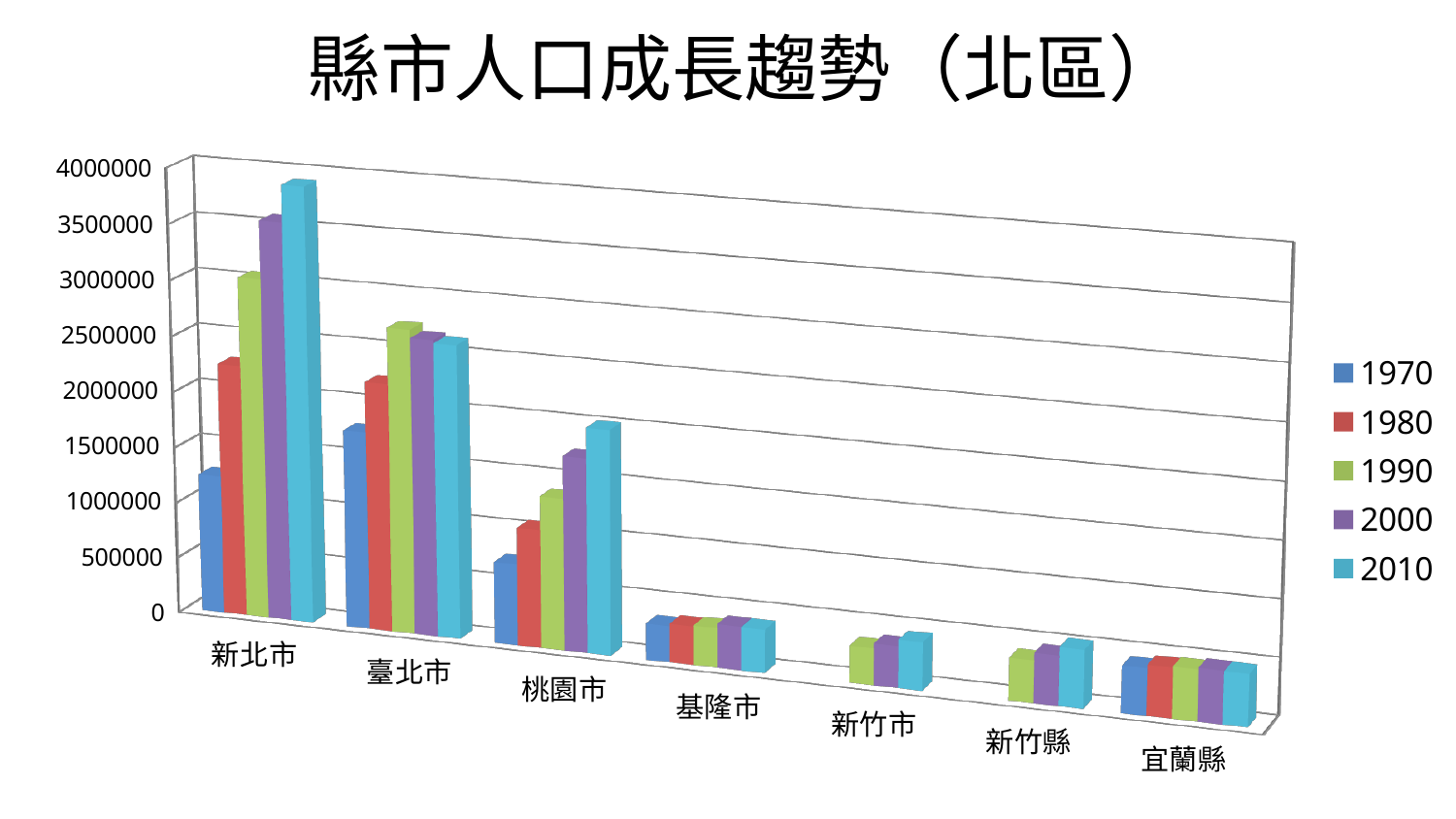
How many series does the legend list? 5 Which is larger for 1970: 新北市 or 臺北市? 臺北市 Which is larger for 桃園市: the 1970 value or the 2010 value? 2010 Which city has the highest value for 2010? 新北市 Do the values for 新北市 rise or fall from 1970 to 2010? rise What is the title of the chart? 縣市人口成長趨勢（北區） How many cities/counties are shown on the x axis? 7 Is the 2010 value for 新北市 greater or less than 3500000? greater What kind of chart is shown on the slide? bar chart Is the 1970 value for 臺北市 greater or less than 2000000? less Is the 1970 value for 新北市 greater or less than 1500000? less Which years are listed in the legend? 1970, 1980, 1990, 2000, 2010